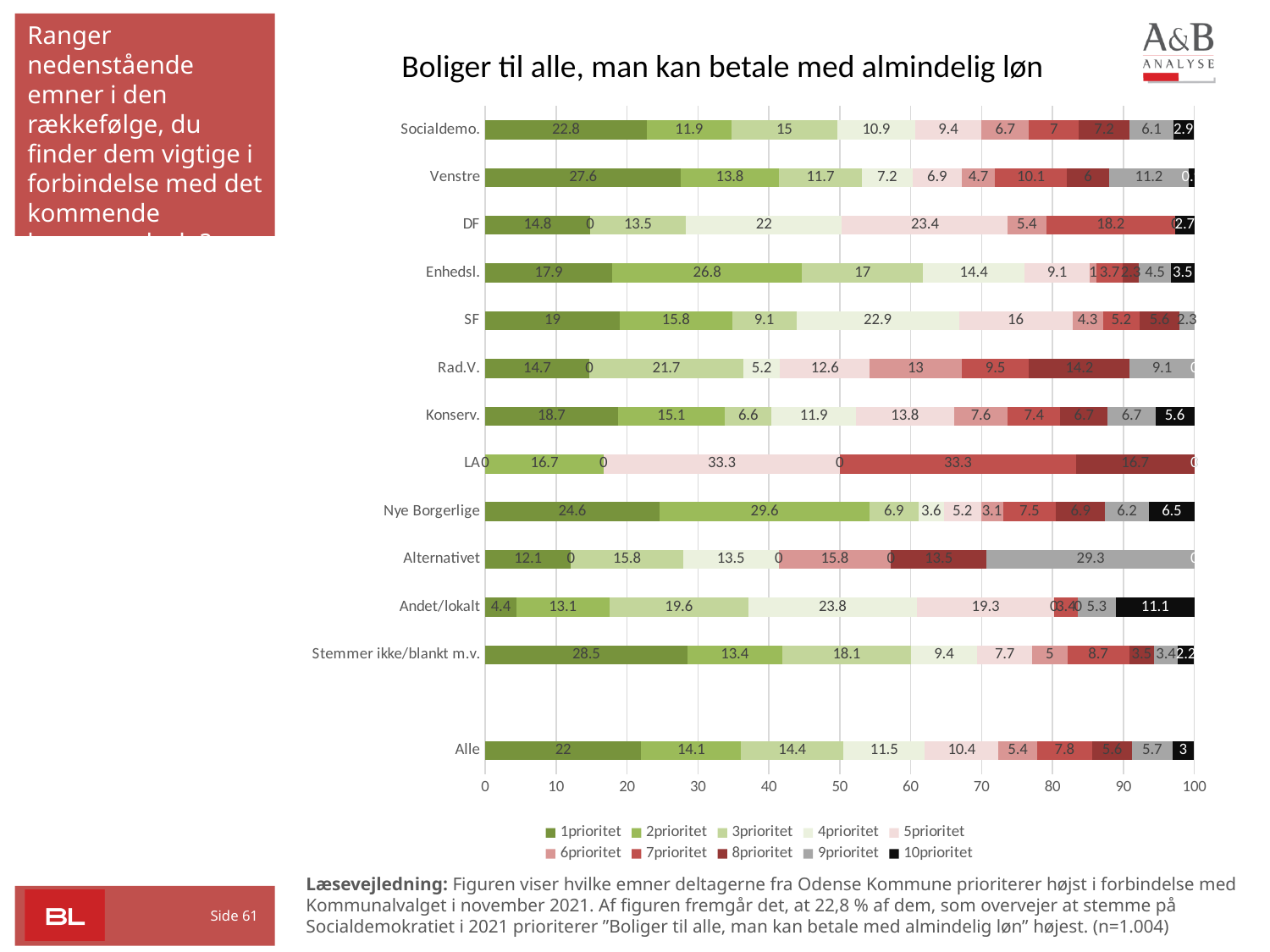
Which has the larger 2prioritet value, Nye Borgerlige or Enhedsl.? Nye Borgerlige What is the 1prioritet value for Alle? 22 What is the 9prioritet value for Alternativet? 29.3 What is the difference between the 1prioritet values for Venstre and Socialdemo.? 4.8 What is the 2prioritet value for Nye Borgerlige? 29.6 How many series does the legend list? 10 What kind of chart is shown on the slide? Stacked bar chart Which category has the highest 1prioritet value? Stemmer ikke/blankt m.v. What is the 1prioritet value for Socialdemo.? 22.8 What is the 10prioritet value for Andet/lokalt? 11.1 What is the 1prioritet value for Venstre? 27.6 How many categories are shown on the y axis? 13